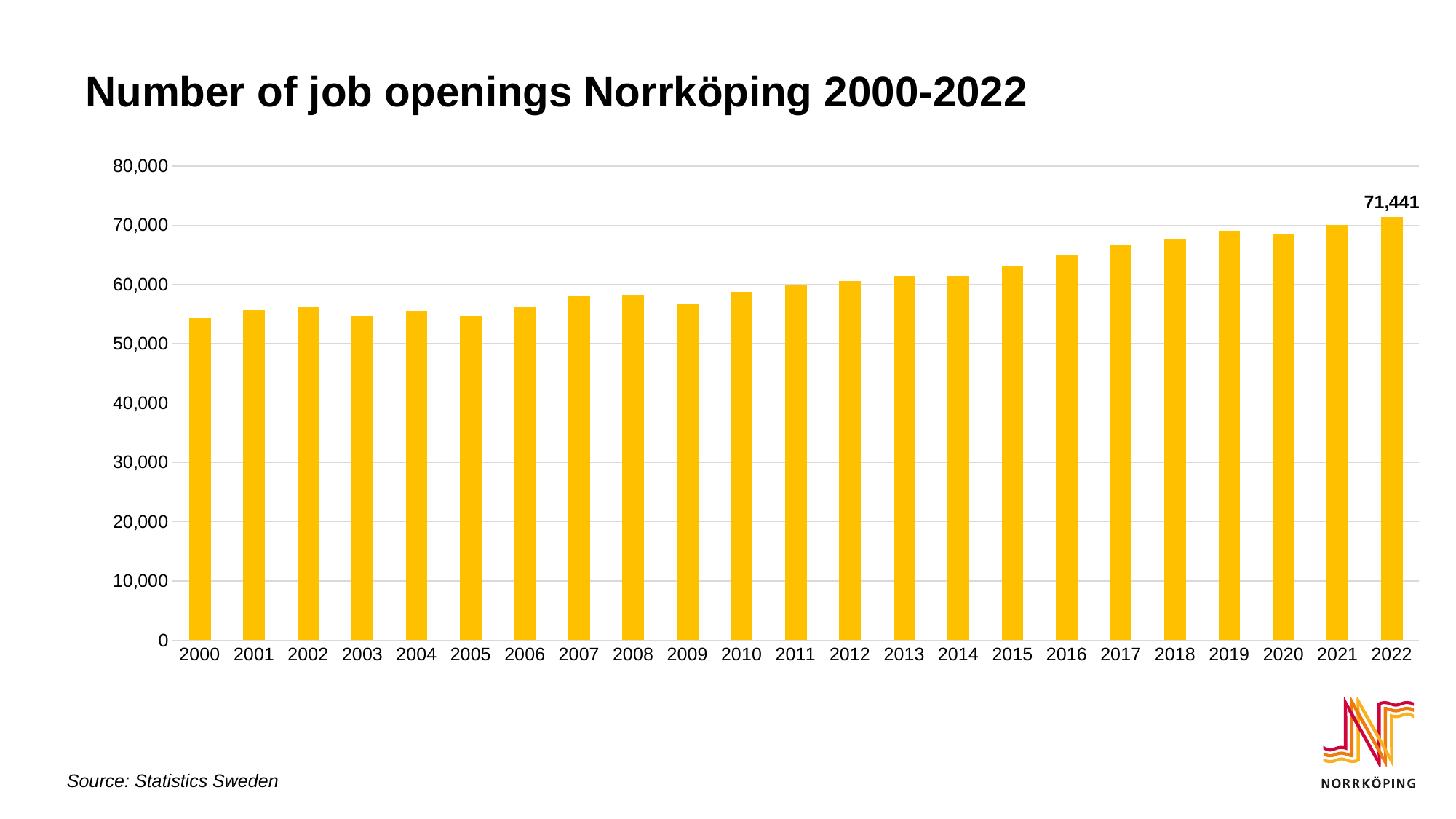
Do the number of job openings generally rise or fall from 2000 to 2022? rise How many years (bars) are shown in the chart? 23 Is the value for 2016 greater or less than 60,000? greater Is the value for 2009 greater or less than 60,000? less What is the source of the data cited on the slide? Statistics Sweden Which year has more job openings, 2000 or 2022? 2022 Which year has the highest number of job openings? 2022 What is the number of job openings in Norrköping in 2022? 71,441 Is the value for 2000 greater or less than 60,000? less Which year has more job openings, 2010 or 2016? 2016 What kind of chart is shown on the slide? bar chart